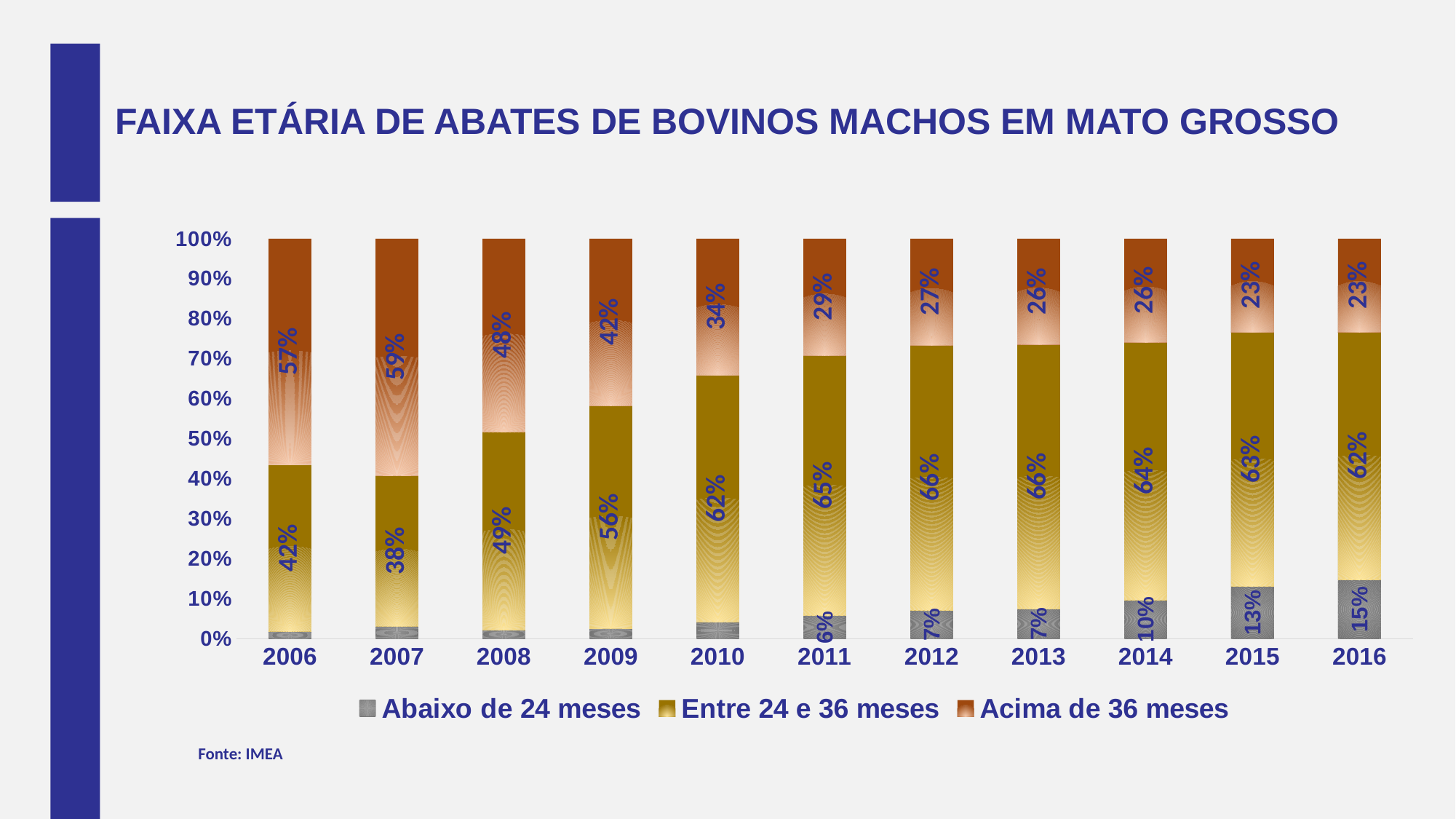
In which year is the 'Acima de 36 meses' share highest? 2007 What is the value for 'Entre 24 e 36 meses' in 2009? 56% What is the value for 'Acima de 36 meses' in 2013? 26% Does the 'Acima de 36 meses' share generally rise or fall from 2006 to 2016? fall How many series does the legend list? 3 Which is larger in 2008: 'Entre 24 e 36 meses' or 'Acima de 36 meses'? Entre 24 e 36 meses In which year is the 'Entre 24 e 36 meses' share lowest? 2007 What is the difference between the 'Acima de 36 meses' values for 2006 and 2016? 34% How many years are shown on the x axis? 11 What is the value for 'Acima de 36 meses' in 2006? 57% What is the value for 'Abaixo de 24 meses' in 2016? 15% What kind of chart is shown on the slide? stacked bar chart